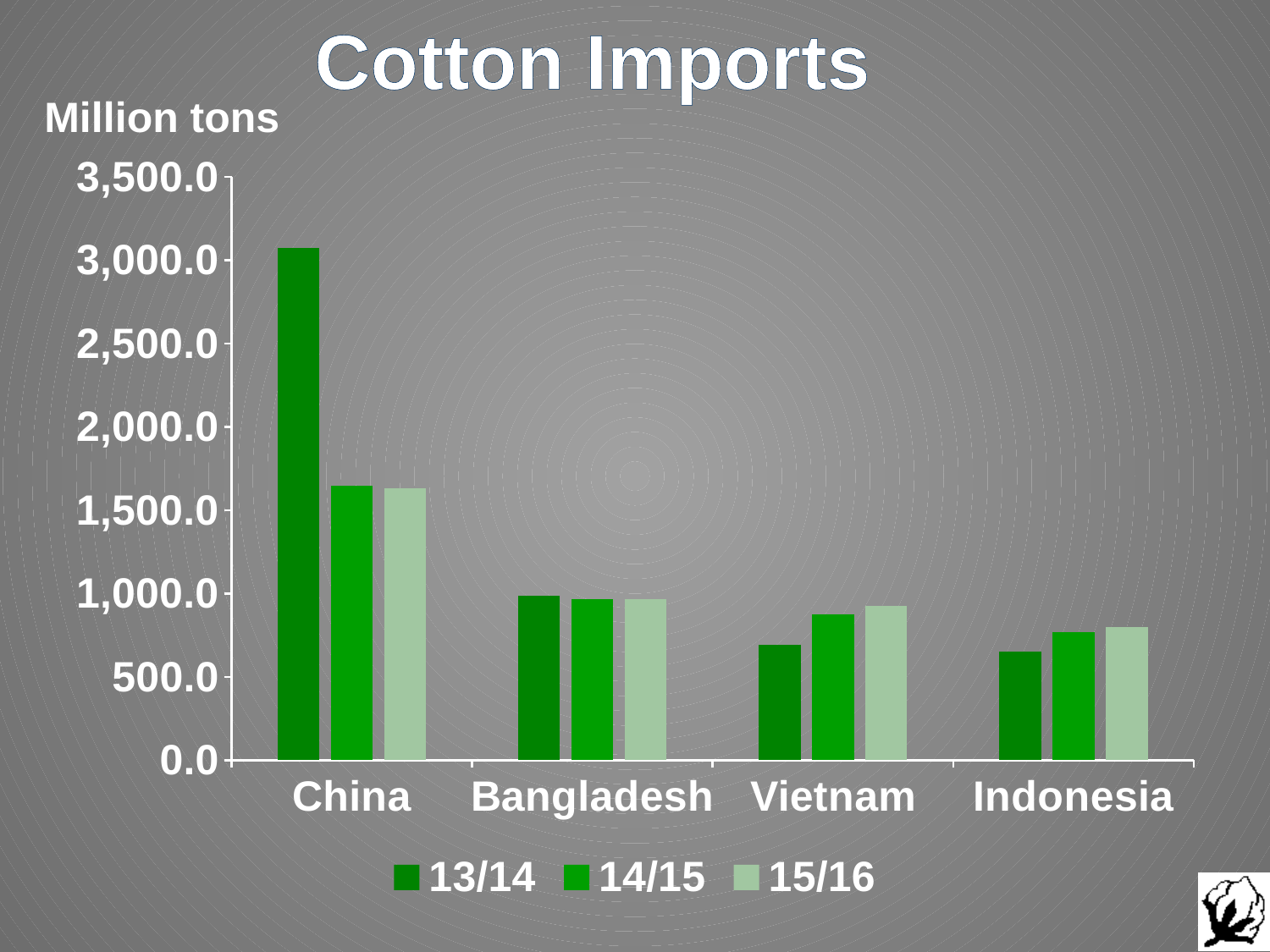
What kind of chart is shown on the slide? bar chart Which country has the highest cotton imports in 13/14? China Is the value for China in 14/15 greater or less than 1,500.0? greater Do Vietnam's cotton imports rise or fall from 13/14 to 15/16? rise How many series does the legend list? 3 What unit is given for the y axis? Million tons How many countries are shown on the x axis? 4 For China, which is larger: the 13/14 value or the 14/15 value? 13/14 Is the value for China in 13/14 greater or less than 2,500.0? greater Is the value for Indonesia in 13/14 greater or less than 500.0? greater Which country has the lowest cotton imports in 15/16? Indonesia